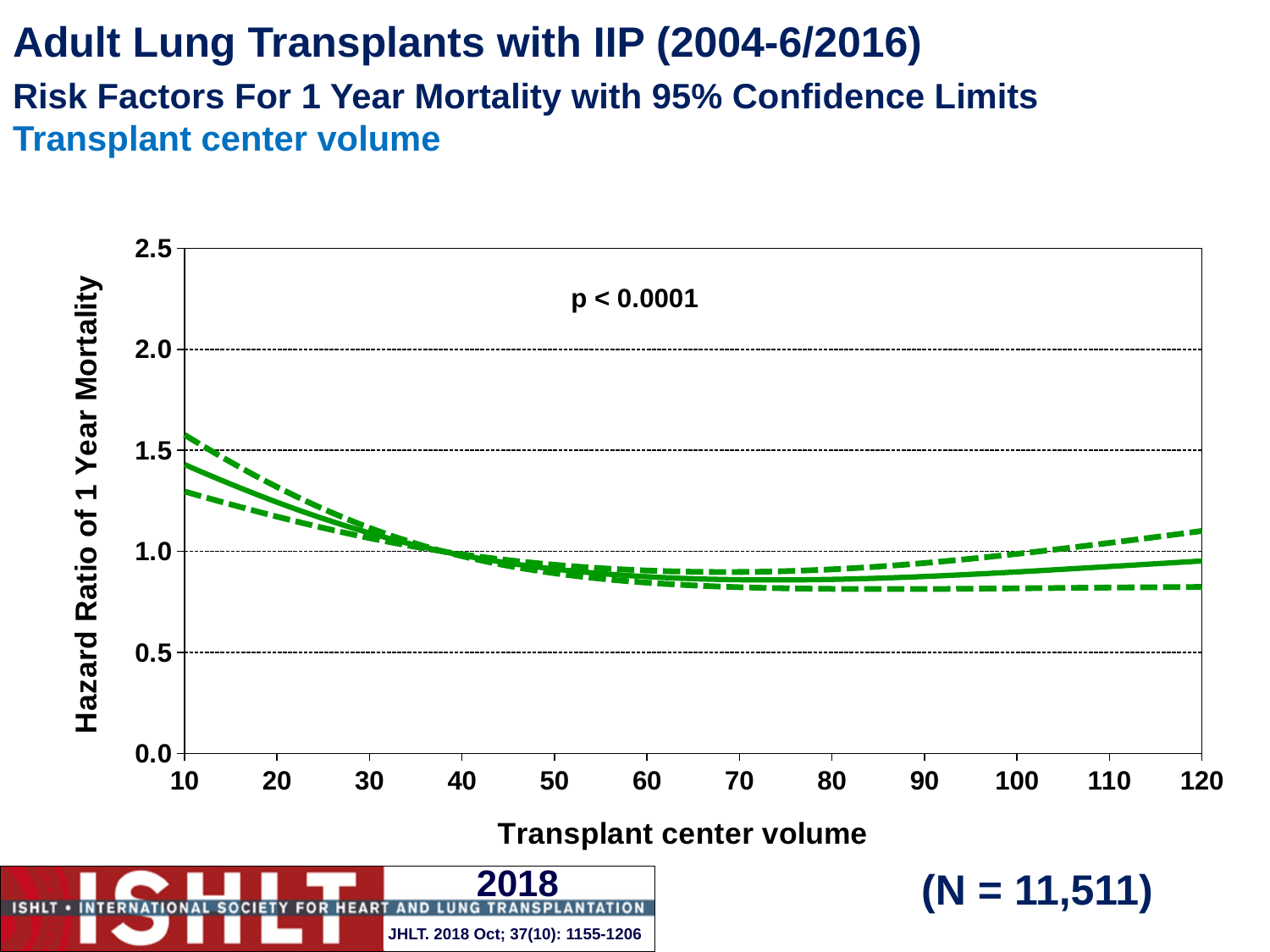
How many lines are plotted on the chart? 3 Is the hazard ratio (solid line) at a transplant center volume of 10 greater or less than 2.0? less What kind of chart is shown on the slide? line chart What p-value is printed on the chart? p < 0.0001 Is the hazard ratio (solid line) at a transplant center volume of 70 greater or less than 1.0? less Does the hazard ratio (solid line) rise or fall as transplant center volume increases from 10 to 40? fall What is the highest value shown on the y axis? 2.5 Is the lower confidence limit (lower dashed line) at a transplant center volume of 10 greater or less than 1.0? greater What is the label of the x axis? Transplant center volume What is the label of the y axis? Hazard Ratio of 1 Year Mortality